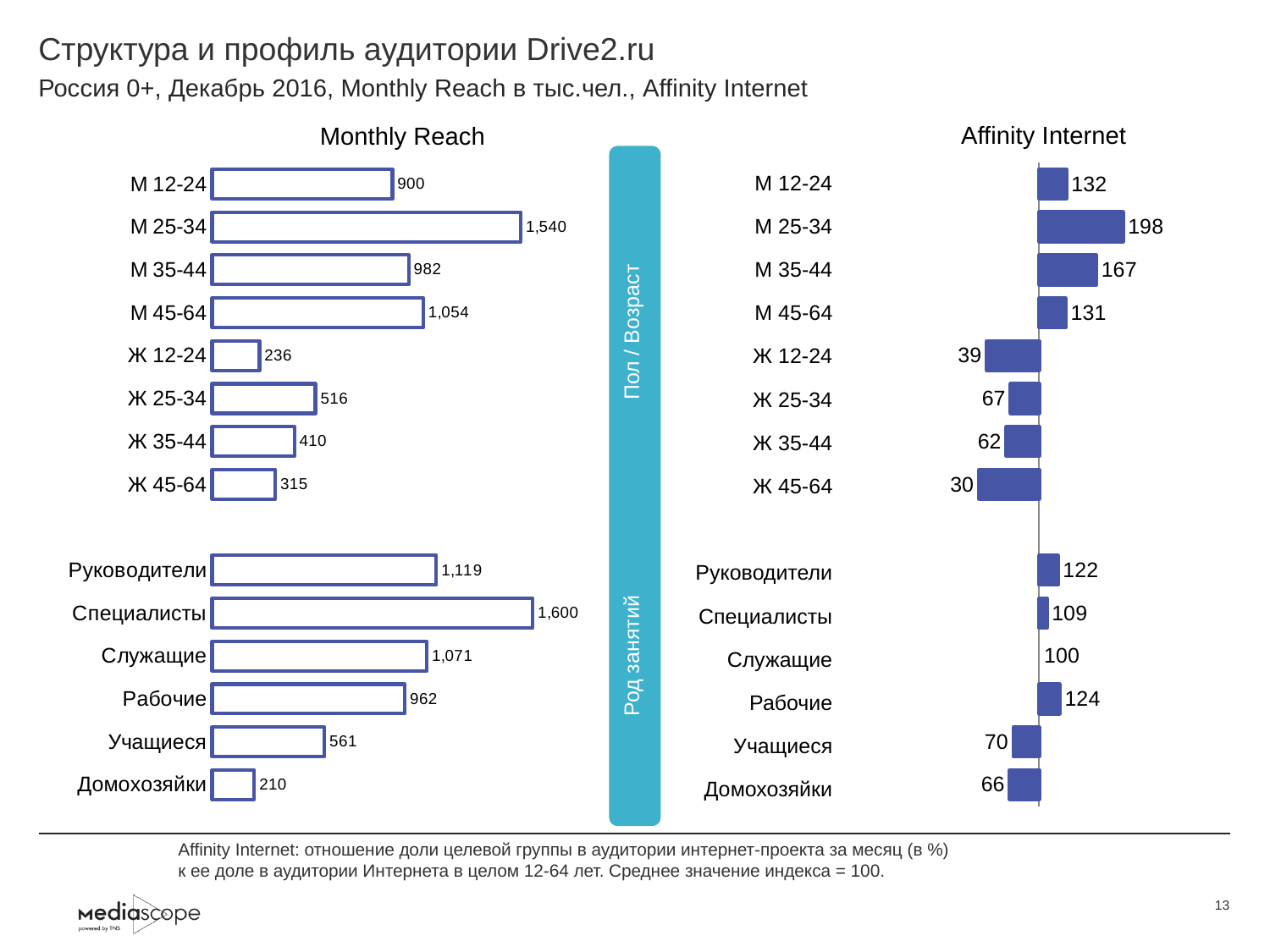
What kind of chart is the Affinity Internet chart? Bar chart In the Affinity Internet chart, what is the value for Служащие? 100 In the Affinity Internet chart, which is larger: the value for М 35-44 or the value for Руководители? М 35-44 In the Monthly Reach chart, what is the value for Домохозяйки? 210 In the Monthly Reach chart, what is the value for М 25-34? 1,540 How many categories are plotted in the Monthly Reach chart? 14 In the Monthly Reach chart, which category has the highest value? Специалисты In the Affinity Internet chart, what is the value for Ж 45-64? 30 In the Affinity Internet chart, what is the difference between the values for М 25-34 and Ж 25-34? 131 In the Affinity Internet chart, which category has the lowest value? Ж 45-64 In the Monthly Reach chart, what is the difference between the values for М 45-64 and Ж 45-64? 739 In the Monthly Reach chart, which category has the lowest value? Домохозяйки